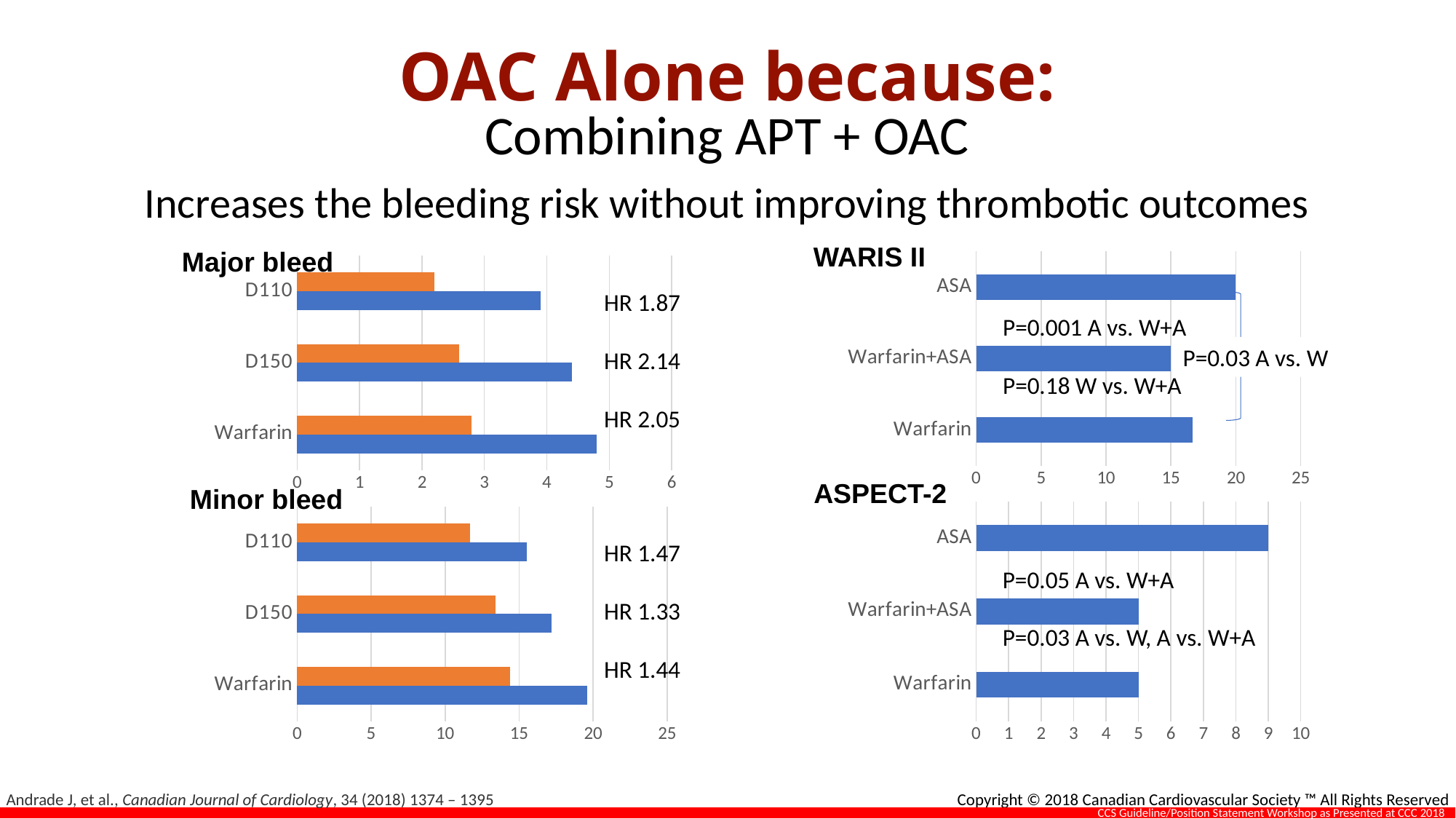
In the WARIS II chart, which category has the lowest value? Warfarin+ASA In the Minor bleed chart, which is longer: the blue bar for D110 or the blue bar for Warfarin? Warfarin In the Major bleed chart, what hazard ratio is printed next to D150? HR 2.14 In the WARIS II chart, what P value is shown for A vs. W? P=0.03 In the Minor bleed chart, is the blue bar for Warfarin greater or less than 15? greater In the WARIS II chart, is the value for Warfarin greater or less than 15? greater In the Major bleed chart, is the blue bar for Warfarin greater or less than 4? greater In the ASPECT-2 chart, which category has the highest value? ASA What kind of chart is the Major bleed chart? bar chart How many categories are shown on the Major bleed chart? 3 In the WARIS II chart, which category has the highest value? ASA